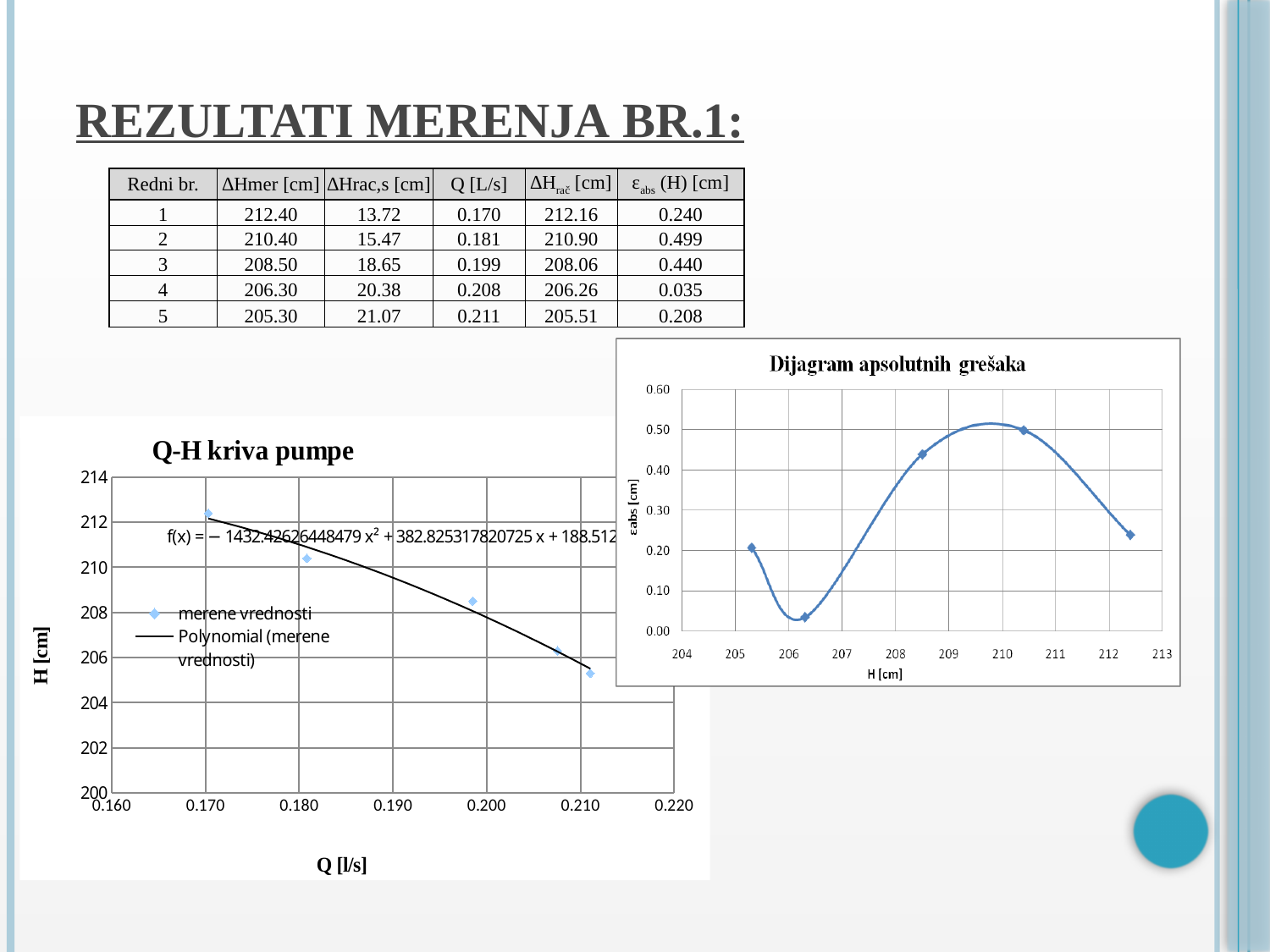
In the 'Dijagram apsolutnih grešaka' chart, how many data points are plotted? 5 In the 'Q-H kriva pumpe' chart, what is the label of the x axis? Q [l/s] In the 'Dijagram apsolutnih grešaka' chart, is the error value at H ≈ 206 greater or less than 0.10? less In the 'Dijagram apsolutnih grešaka' chart, is the error value at H ≈ 210 greater or less than 0.40? greater In the 'Q-H kriva pumpe' chart, do the H values rise or fall as Q increases along the x axis? fall In the 'Q-H kriva pumpe' chart, how many entries does the legend list? 2 What is the title of the chart on the left of the slide? Q-H kriva pumpe In the 'Q-H kriva pumpe' chart, how many measured data points are plotted? 5 In the 'Q-H kriva pumpe' chart, is the H value of the point at Q = 0.170 greater or less than 212? greater What is the title of the chart on the right of the slide? Dijagram apsolutnih grešaka In the 'Dijagram apsolutnih grešaka' chart, which is larger: the error value at H ≈ 208.5 or the error value at H ≈ 212.4? the value at H ≈ 208.5